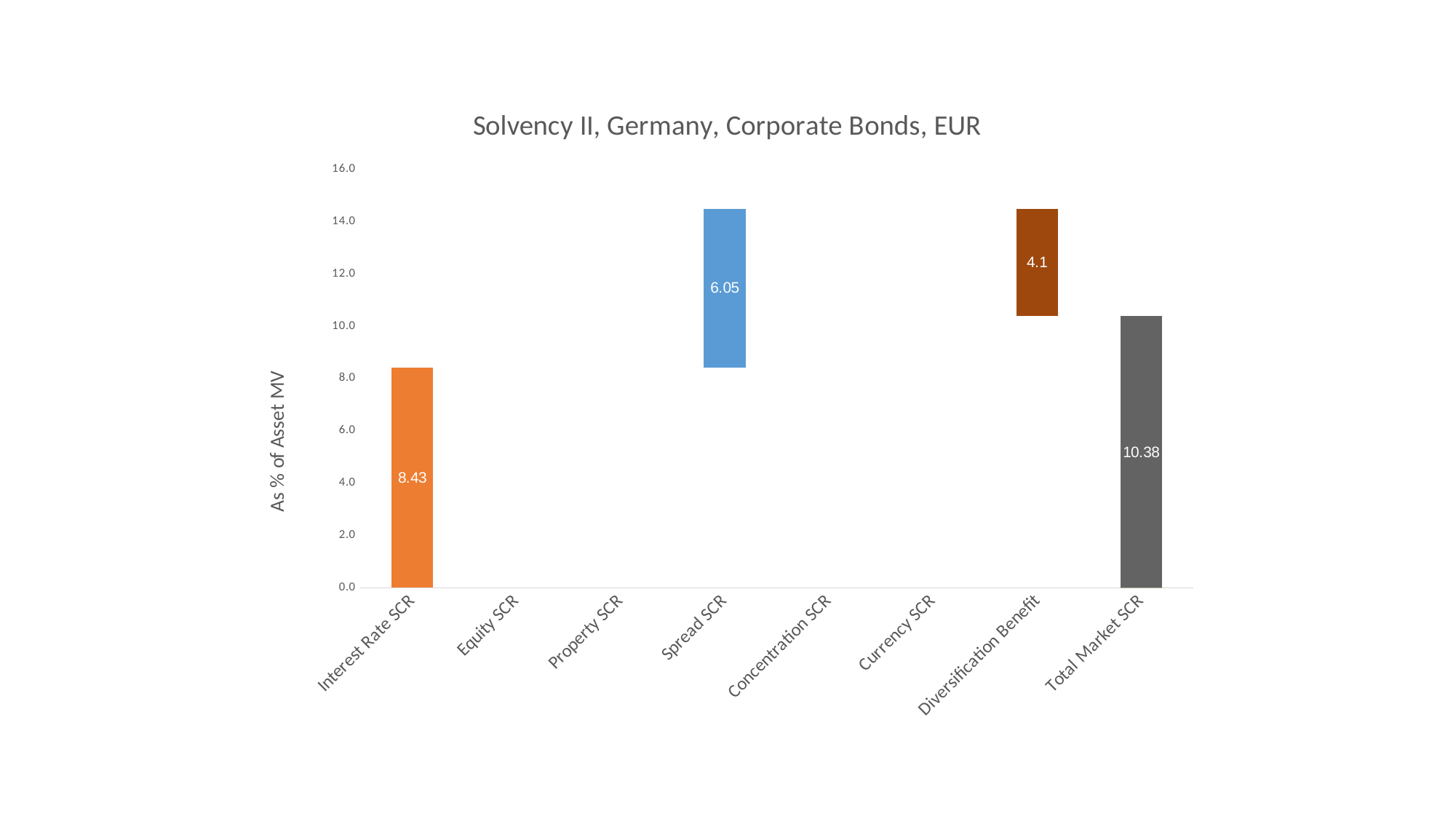
What is the value shown for Interest Rate SCR? 8.43 What is the difference between the Interest Rate SCR value and the Spread SCR value? 2.38 What is the title of the chart? Solvency II, Germany, Corporate Bonds, EUR How many categories are listed on the x axis? 8 What is the value shown for Diversification Benefit? 4.1 What is the value shown for Spread SCR? 6.05 Which category has the largest labelled value? Total Market SCR What is the value shown for Total Market SCR? 10.38 Which is larger, the value for Interest Rate SCR or the value for Spread SCR? Interest Rate SCR Is the value for Total Market SCR greater or less than 10.0? greater What kind of chart is shown on the slide? Bar chart Which category has the smallest labelled value? Diversification Benefit